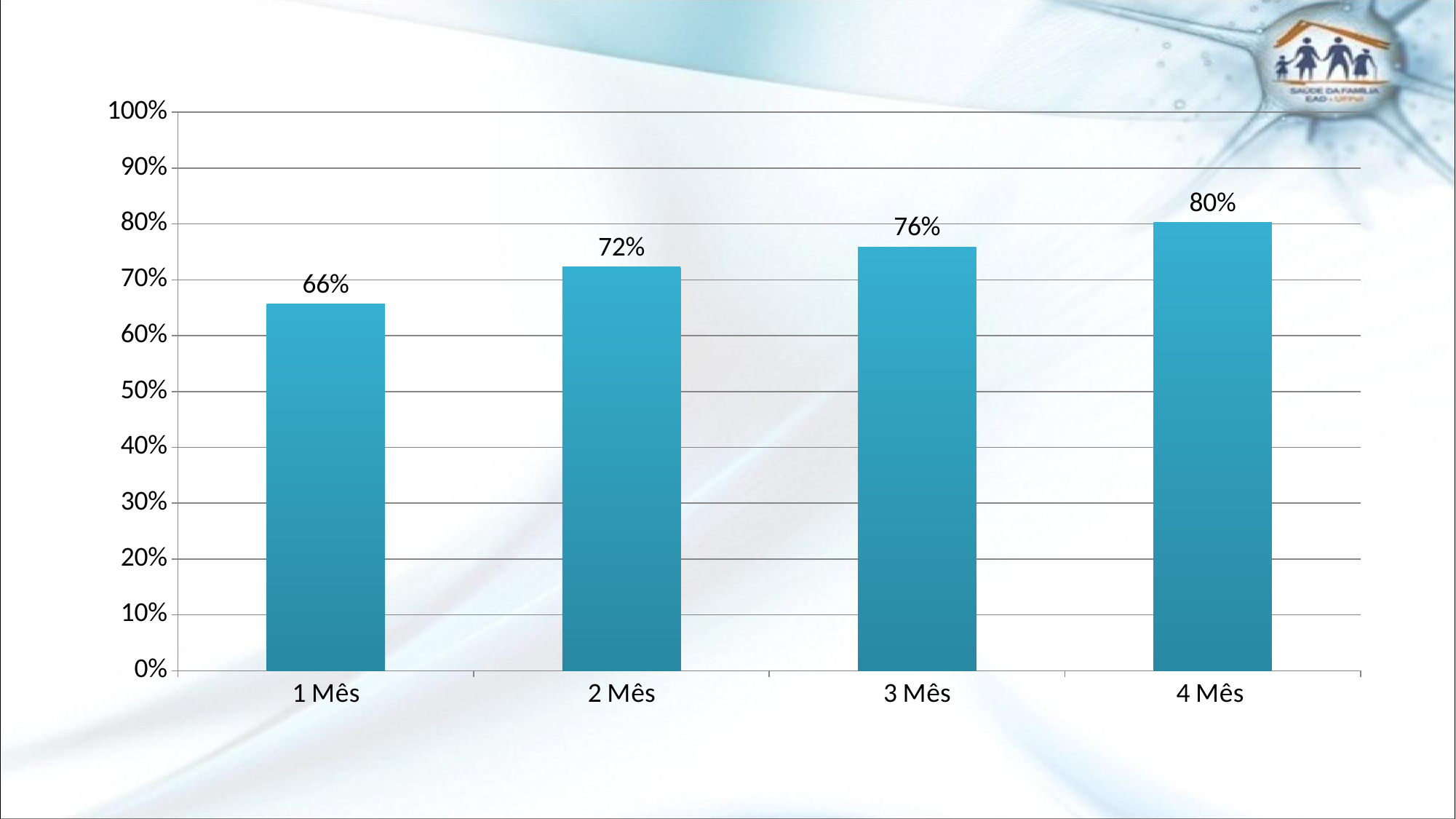
How many categories are shown on the x axis? 4 Which is larger, the value for 2 Mês or the value for 3 Mês? 3 Mês What is the value for 2 Mês? 72% What kind of chart is shown on the slide? bar chart Which category has the lowest value? 1 Mês What is the value for 3 Mês? 76% What is the difference between the values for 3 Mês and 2 Mês? 4% What is the difference between the values for 4 Mês and 1 Mês? 14% What is the value for 1 Mês? 66% Which category has the highest value? 4 Mês Is the value for 1 Mês greater or less than 70%? less What is the value for 4 Mês? 80%